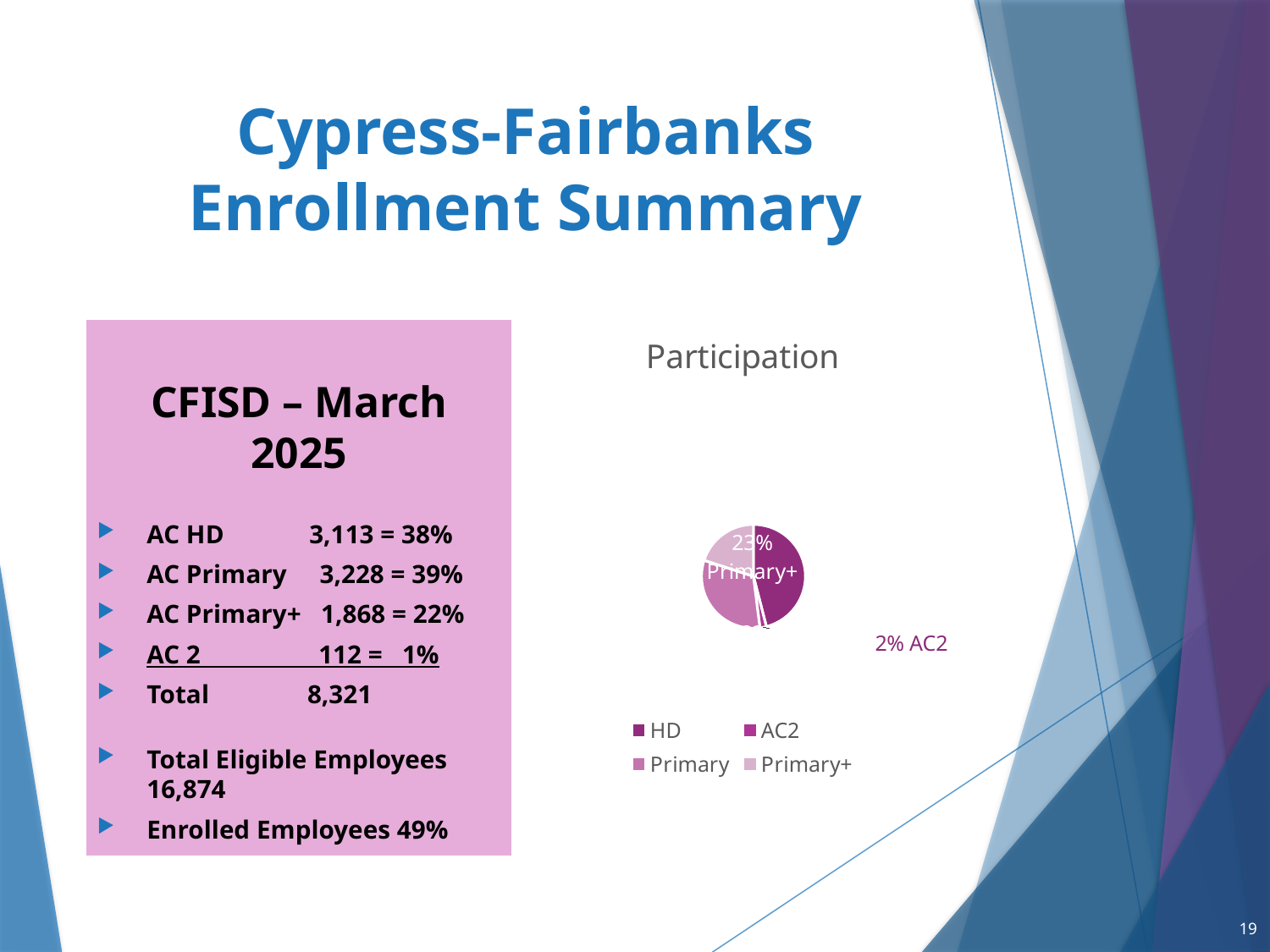
Which legend entries are listed in the Participation pie chart? HD, AC2, Primary, Primary+ How many slices does the Participation pie chart have? 4 In the Participation pie chart, which slice is larger, HD or AC2? HD Which slice of the Participation pie chart is the smallest? AC2 What is the title of the chart on the right side of the slide? Participation How many entries does the legend of the Participation pie chart list? 4 In the Participation pie chart, what share is labelled for AC2? 2% What kind of chart is shown under the title "Participation"? pie chart In the Participation pie chart, which slice is larger, Primary+ or AC2? Primary+